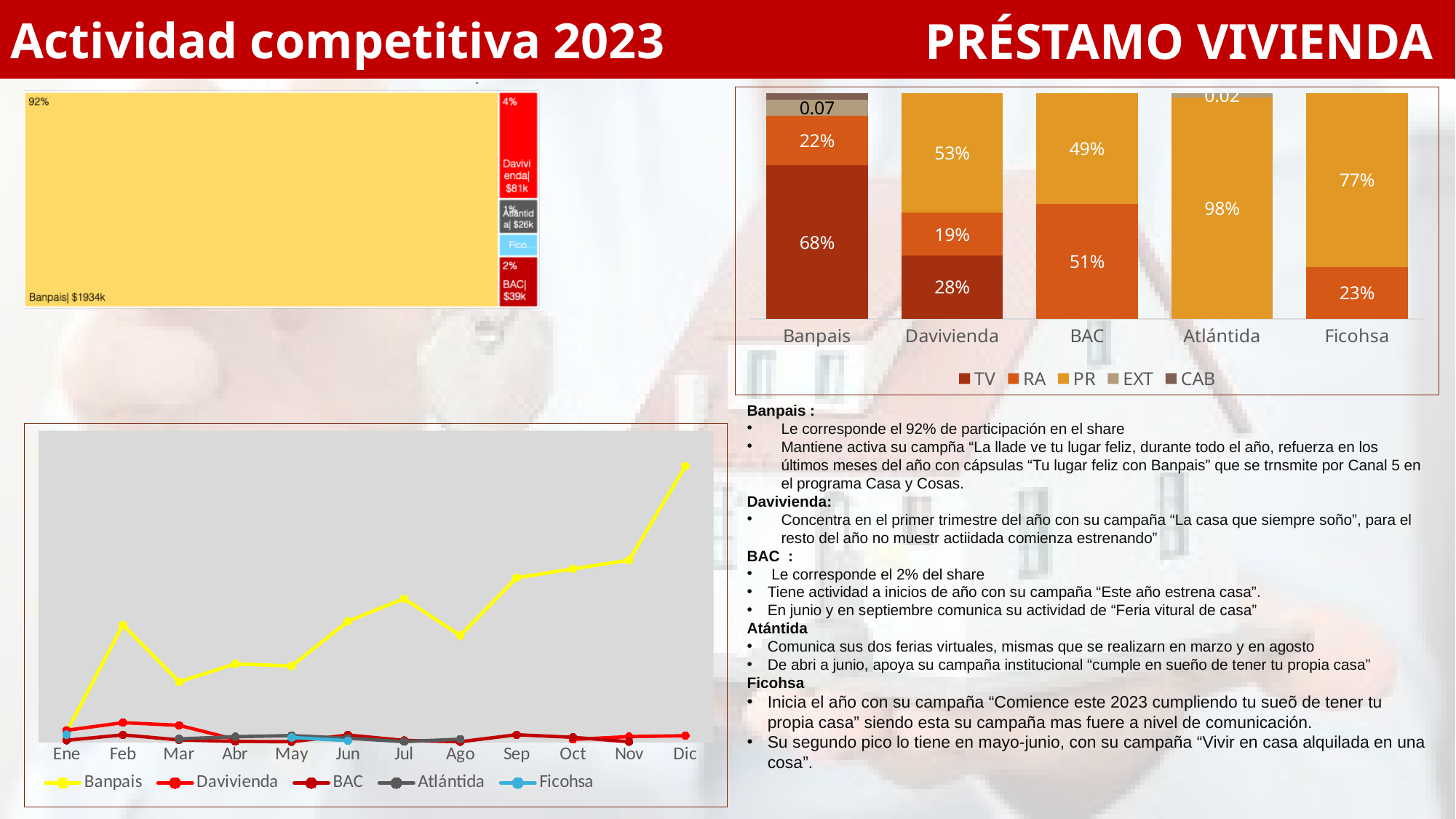
In the treemap on the top left, what share does Banpais have? 92% In the stacked bar chart on the top right, how many series does the legend list? 5 In the stacked bar chart on the top right, what is the TV share for Banpais? 68% In the line chart on the bottom left, how many months are shown on the x axis? 12 In the stacked bar chart on the top right, what is the RA share for Ficohsa? 23% In the stacked bar chart on the top right, what is the PR share for Atlántida? 98% In the line chart on the bottom left, which series has the highest value in Dic? Banpais In the stacked bar chart on the top right, what is the PR share for Davivienda? 53% In the stacked bar chart on the top right, which bank has the highest PR share? Atlántida In the stacked bar chart on the top right, what is the difference between the PR share and the RA share for Ficohsa? 54% In the treemap on the top left, what is the value shown for Davivienda? $81k In the stacked bar chart on the top right, what is the RA share for BAC? 51%